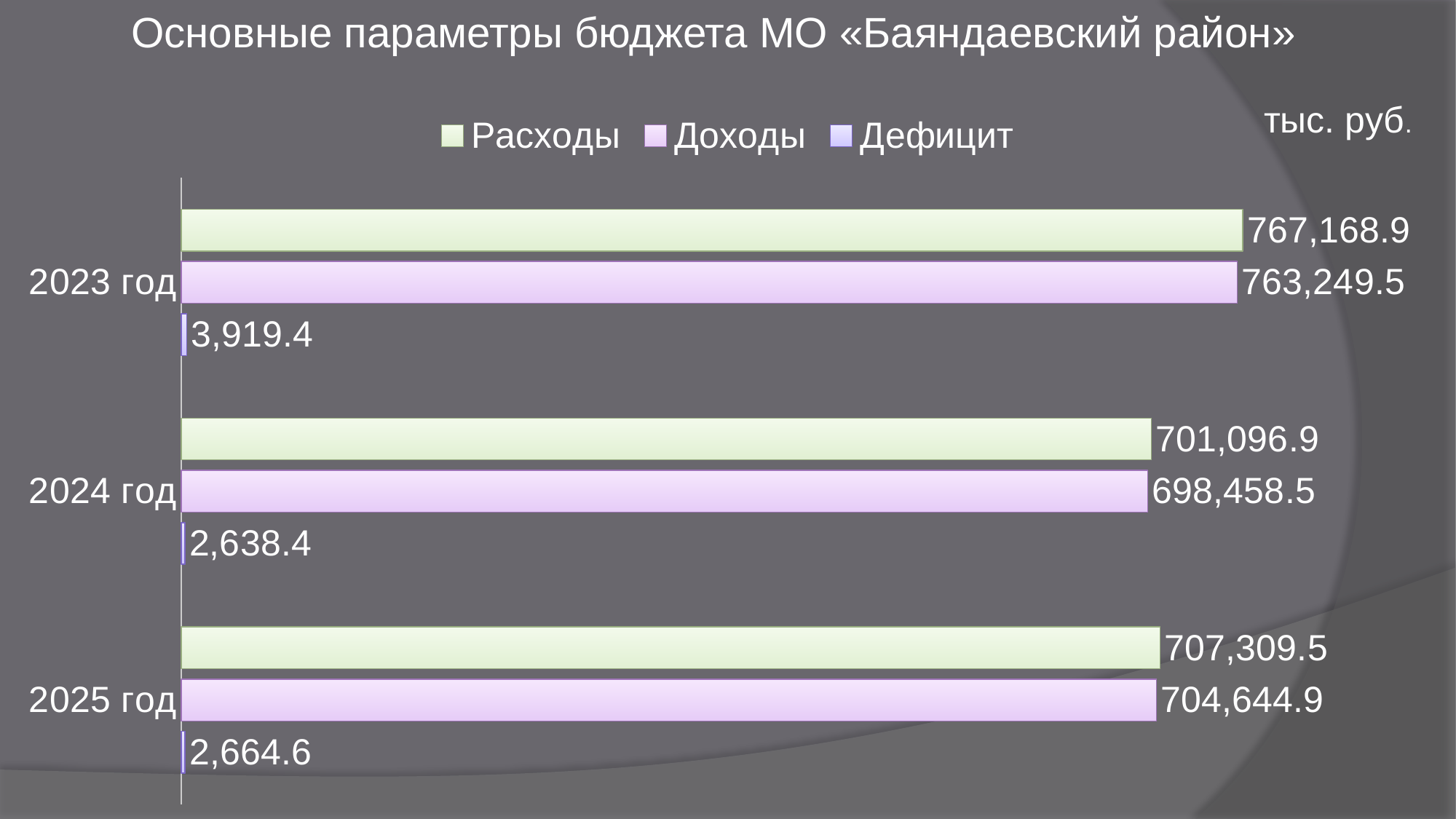
What unit is indicated for the values on the chart? тыс. руб. How many series does the legend list? 3 What is the value of Дефицит for 2025 год? 2,664.6 What is the difference between Расходы and Доходы for 2025 год? 2,664.6 In which year is Дефицит the lowest? 2024 год Which is larger for 2024 год: Расходы or Доходы? Расходы What is the title of the chart? Основные параметры бюджета МО «Баяндаевский район» What is the value of Доходы for 2024 год? 698,458.5 How many years (categories) are shown on the chart? 3 In which year is Расходы the highest? 2023 год What type of chart is shown on the slide? bar chart What is the value of Расходы for 2023 год? 767,168.9